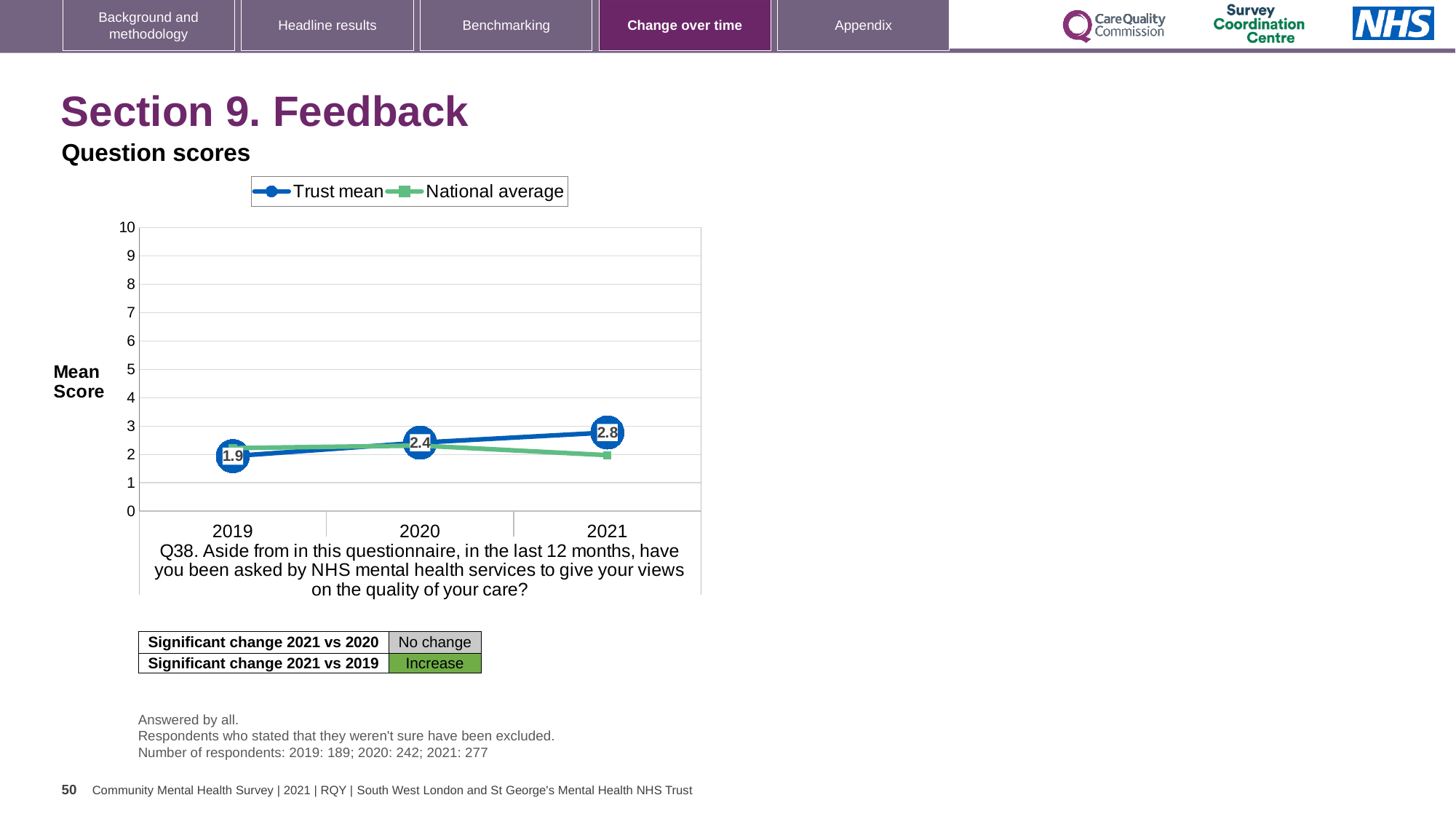
How many series does the legend list? 2 What is the Trust mean score for 2020? 2.4 What is the difference between the Trust mean score in 2021 and in 2019? 0.9 In which year is the Trust mean score highest? 2021 What kind of chart is shown on the slide? line chart In 2021, which is larger: the Trust mean or the National average? Trust mean Is the National average value for 2021 greater or less than 3? less What is the Trust mean score for 2019? 1.9 How many years are plotted on the x axis? 3 In which year is the Trust mean score lowest? 2019 What is the Trust mean score for 2021? 2.8 What is the difference between the Trust mean score in 2020 and in 2019? 0.5